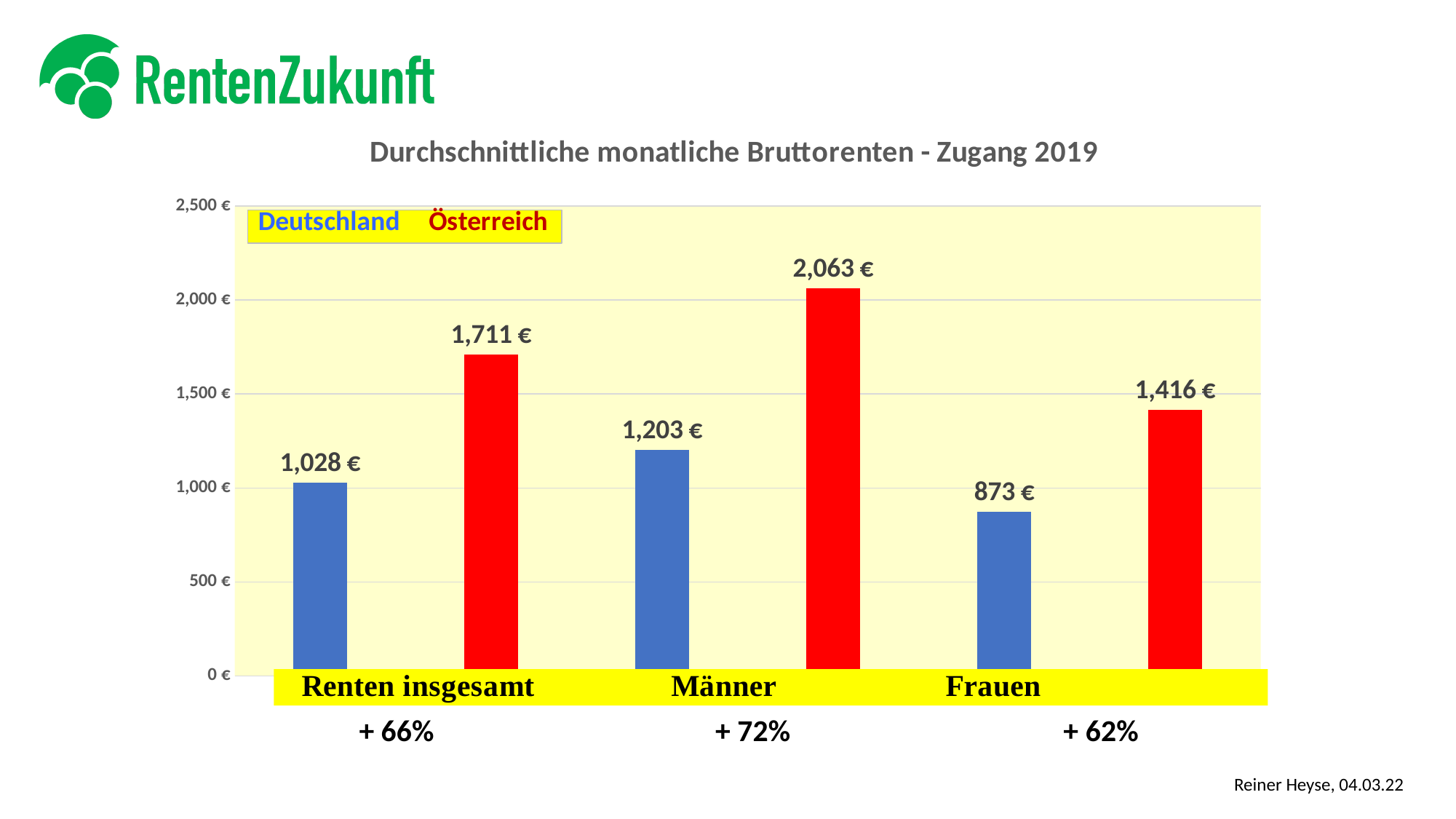
What is the value for Österreich in the Männer category? 2,063 € What kind of chart is shown on the slide? bar chart What is the value for Österreich in the Frauen category? 1,416 € What is the value for Deutschland in the Renten insgesamt category? 1,028 € How many categories are shown on the x axis? 3 Which category has the lowest value for Deutschland? Frauen Which is larger in the Renten insgesamt category, the Deutschland value or the Österreich value? Österreich What is the difference between the Österreich and Deutschland values in the Männer category? 860 € What is the value for Deutschland in the Frauen category? 873 € Is the value for Deutschland in the Männer category greater or less than 1,000 €? greater How many series does the legend list? 2 Which category has the highest value for Österreich? Männer